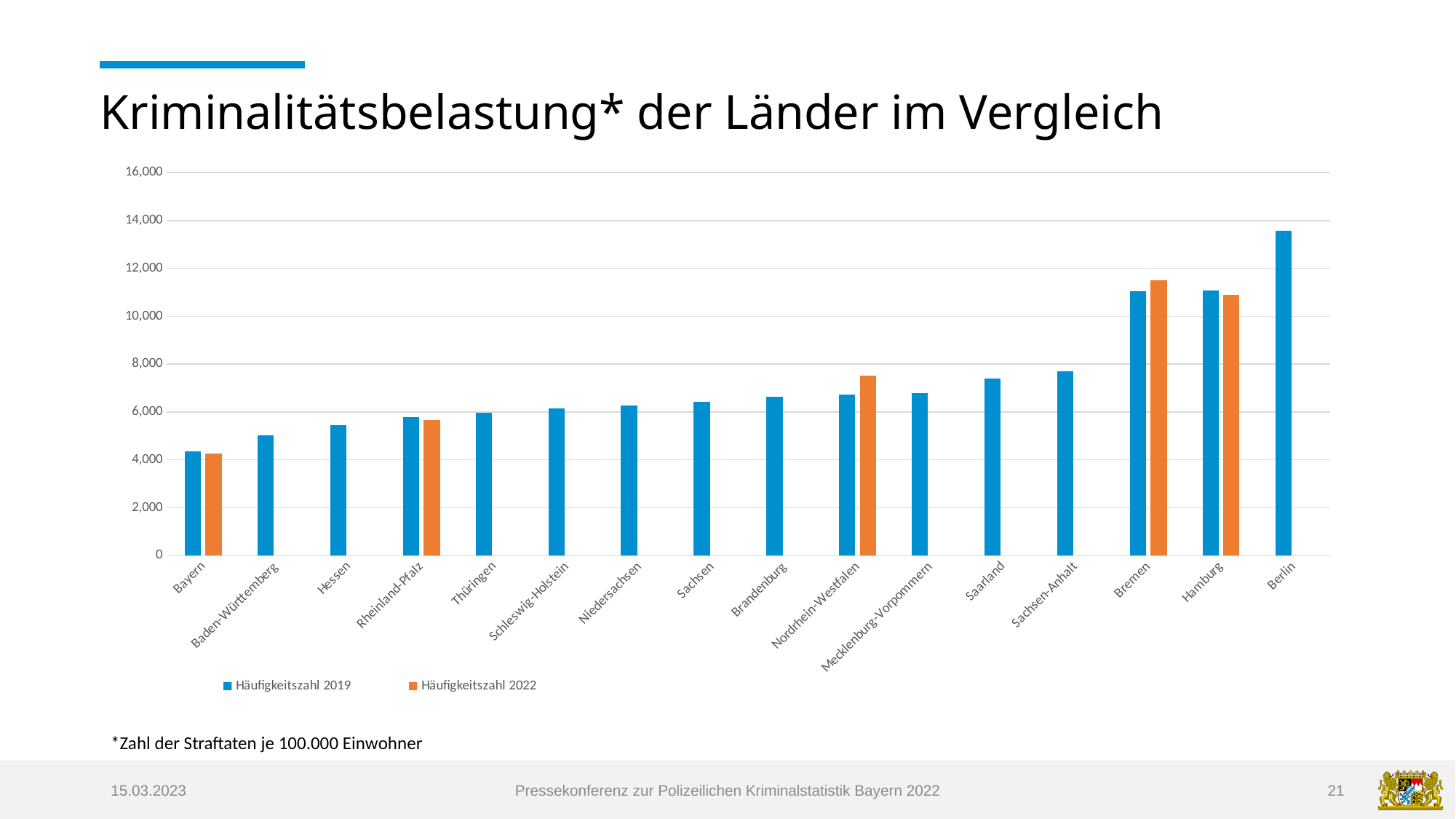
Is the Häufigkeitszahl 2022 for Nordrhein-Westfalen greater or less than 6,000? greater For Bremen, which is larger: the Häufigkeitszahl 2019 or the Häufigkeitszahl 2022? Häufigkeitszahl 2022 How many Länder (categories) are shown on the x axis? 16 Is the Häufigkeitszahl 2022 for Bayern greater or less than 6,000? less Do the Häufigkeitszahl 2019 values rise or fall from Bayern on the left to Berlin on the right? rise Which Land has the lowest Häufigkeitszahl 2019? Bayern Is the Häufigkeitszahl 2022 for Bremen greater or less than 10,000? greater Which Land has the highest Häufigkeitszahl 2019? Berlin How many series does the legend list? 2 What kind of chart is shown on the slide? bar chart Which colour represents Häufigkeitszahl 2022 in the legend? orange